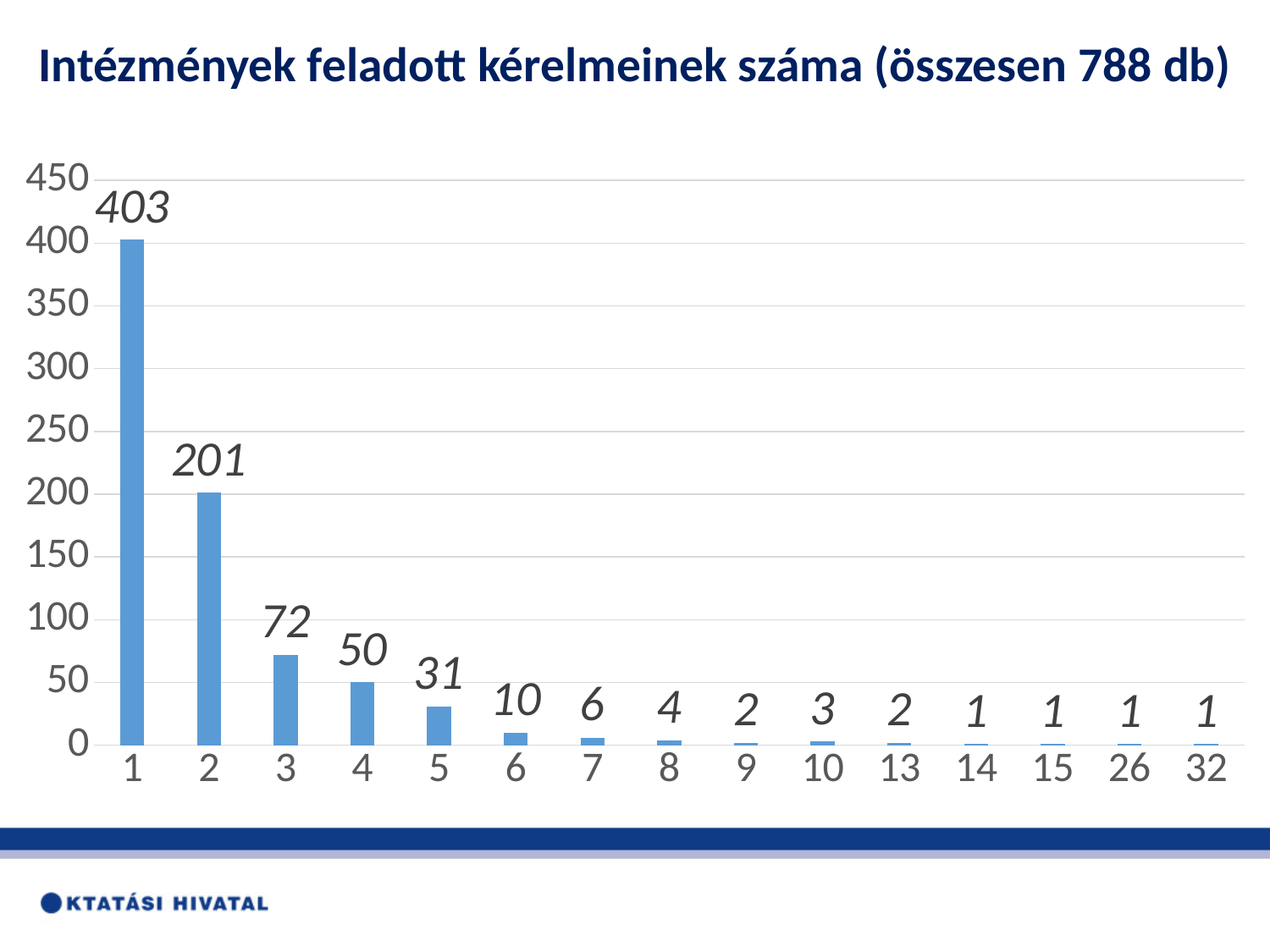
Is the value for category 2 greater or less than 250? less What is the value for category 3? 72 What is the title of the chart? Intézmények feladott kérelmeinek száma (összesen 788 db) How many categories are shown on the x axis? 15 What kind of chart is shown on the slide? bar chart What is the difference between the values for categories 3 and 4? 22 What is the value for category 5? 31 What is the value for category 1? 403 What is the value for category 10? 3 What is the difference between the values for categories 1 and 2? 202 Which is larger, the value for category 6 or the value for category 7? category 6 Which category has the highest value? 1